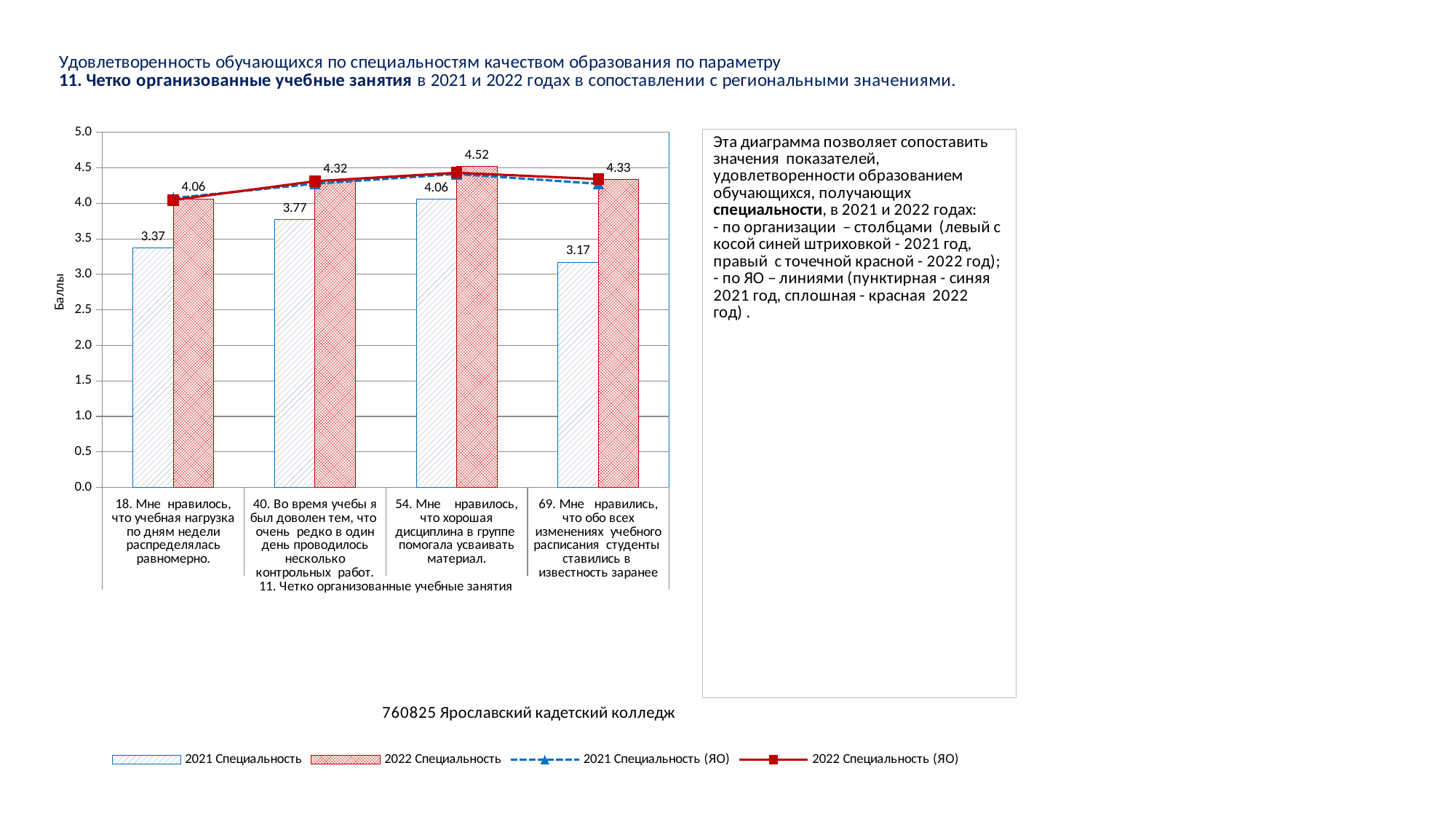
Is the 2021 Специальность value for category 69 greater or less than 3.5? less What is the difference between the 2022 and 2021 Специальность values for category 69? 1.16 How many series does the legend list? 4 What is the 2022 Специальность value for category 69 (Мне нравились, что обо всех изменениях учебного расписания студенты ставились в известность заранее)? 4.33 Which category has the lowest 2021 Специальность value? 69. Мне нравились, что обо всех изменениях учебного расписания студенты ставились в известность заранее Which category has the highest 2022 Специальность value? 54. Мне нравилось, что хорошая дисциплина в группе помогала усваивать материал What is the difference between the 2022 and 2021 Специальность values for category 40? 0.55 How many categories are shown on the x axis? 4 What is the 2021 Специальность value for category 18 (Мне нравилось, что учебная нагрузка по дням недели распределялась равномерно)? 3.37 What is the 2022 Специальность value for category 54 (Мне нравилось, что хорошая дисциплина в группе помогала усваивать материал)? 4.52 What is the label of the vertical axis? Баллы Which is larger for category 18: the 2021 Специальность value or the 2022 Специальность value? 2022 Специальность